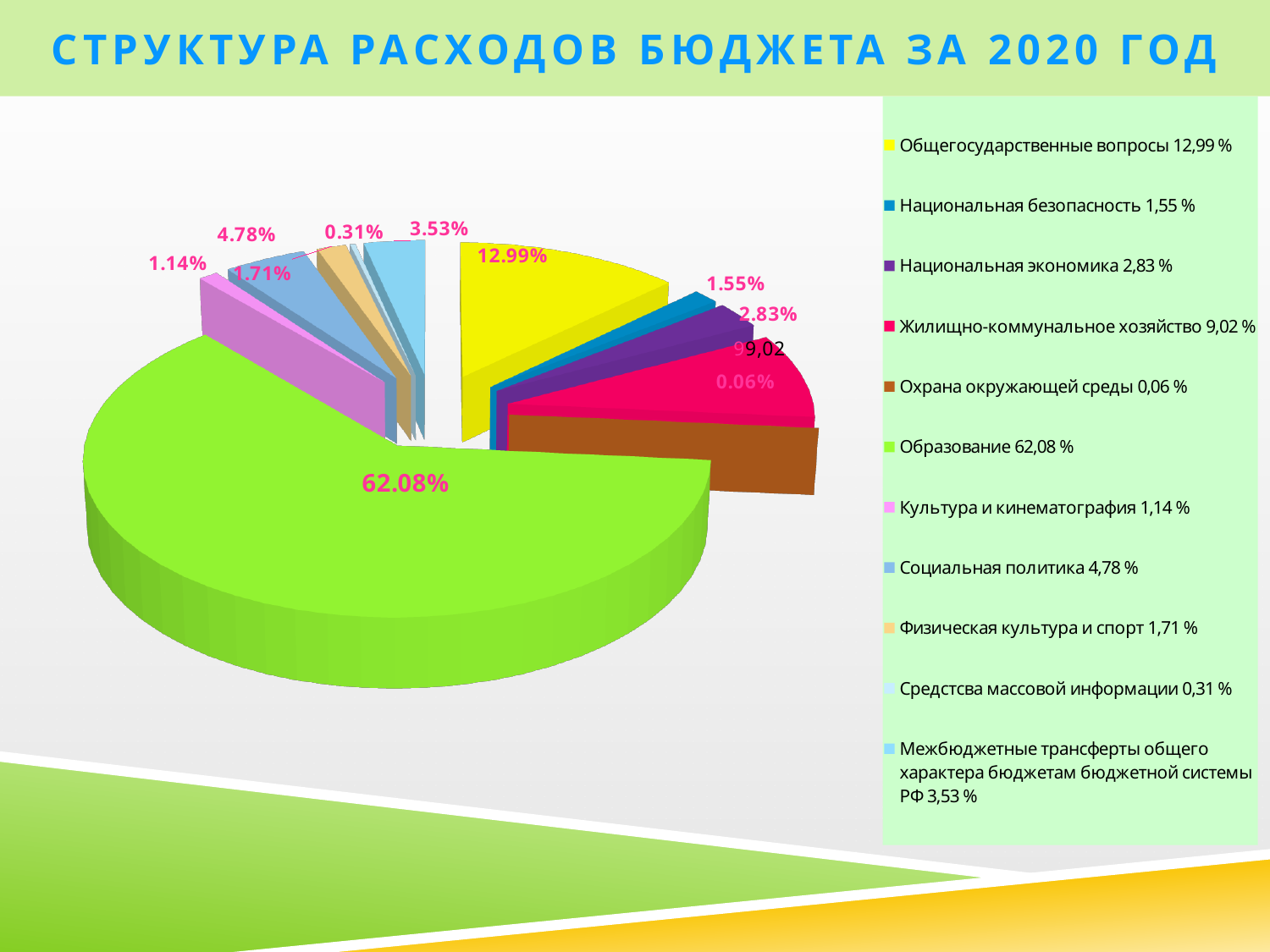
What is the value shown for Межбюджетные трансферты общего характера бюджетам бюджетной системы РФ? 3.53% What share of the pie does Образование take? 62.08% Which category has the largest share of the pie? Образование What is the value shown for Общегосударственные вопросы? 12.99% What is the difference between the values for Образование and Общегосударственные вопросы? 49.09% Which category has the smallest share of the pie? Охрана окружающей среды What kind of chart is shown on the slide? pie chart What is the value shown for Социальная политика? 4.78% Which is larger: Национальная безопасность or Национальная экономика? Национальная экономика What is the value shown for Жилищно-коммунальное хозяйство? 9,02 % How many categories does the pie chart have? 11 What is the title of the slide? СТРУКТУРА РАСХОДОВ БЮДЖЕТА ЗА 2020 ГОД